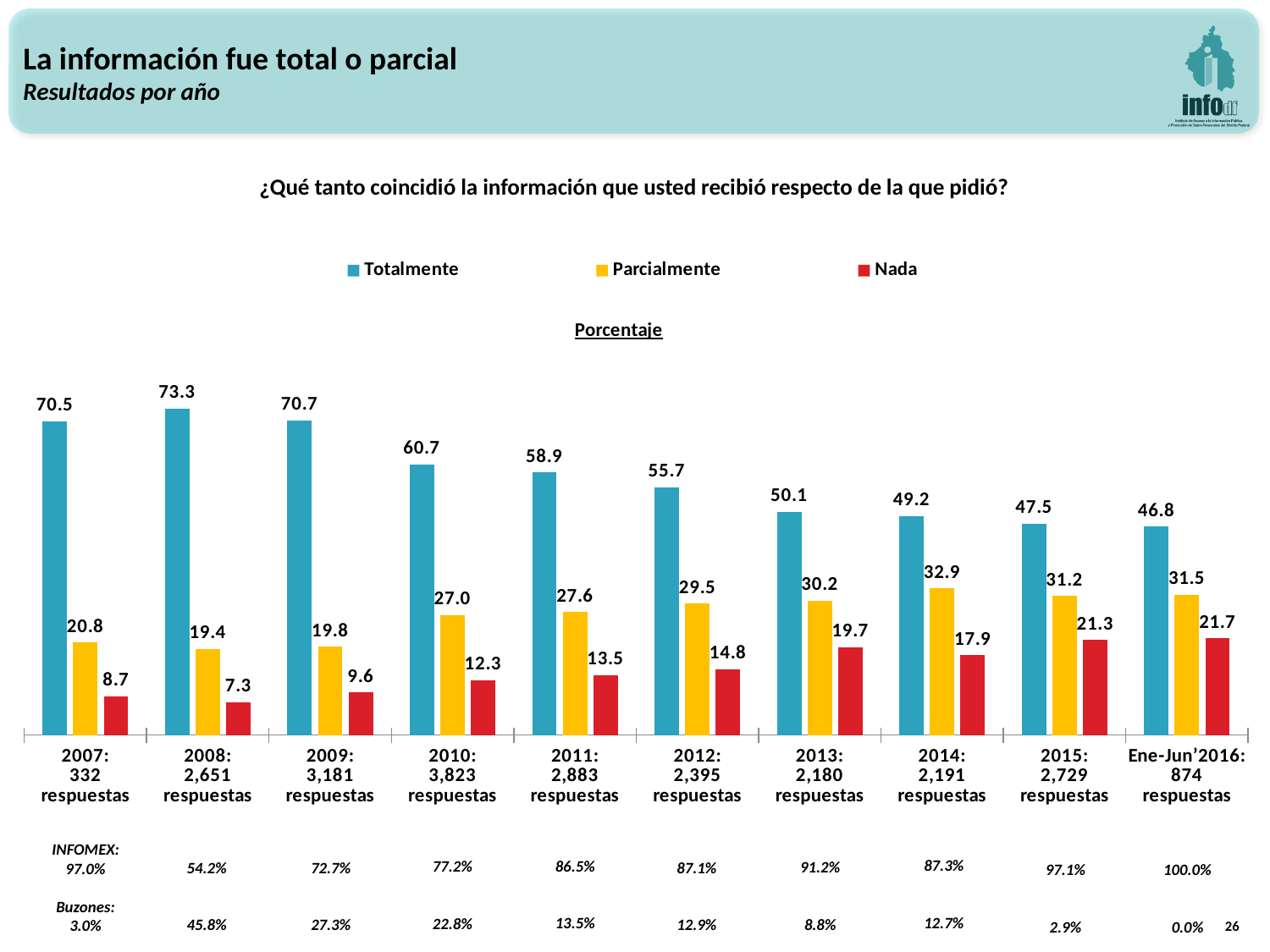
What is the value for Parcialmente in Ene-Jun'2016? 31.5 What is the difference between the Totalmente values for 2007 and Ene-Jun'2016? 23.7 Which is larger, the Parcialmente value for 2014 or for 2015? 2014 What is the value for Totalmente in 2008? 73.3 What is the value for Nada in 2014? 17.9 What kind of chart is shown on the slide? bar chart What colour represents the Nada series in the legend? red Which year has the highest value for Totalmente? 2008 Does the Totalmente series rise or fall from 2009 to Ene-Jun'2016? fall How many year categories are shown on the x axis? 10 Which year has the lowest value for Nada? 2008 How many series does the legend list? 3